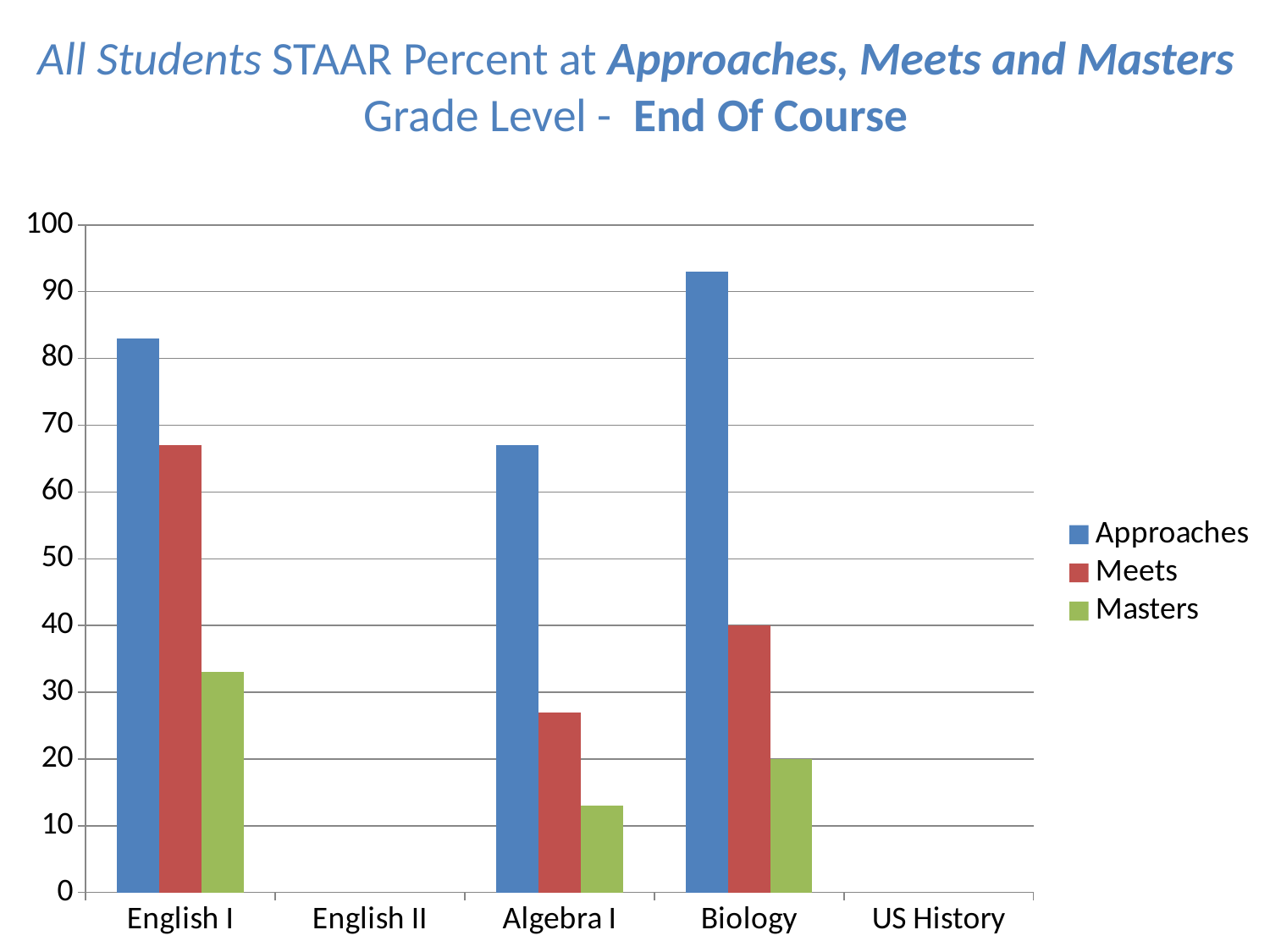
Which is larger, the Approaches value for Algebra I or the Approaches value for English I? English I How many series does the legend list? 3 What kind of chart is shown on the slide? bar chart Is the Masters value for English I greater or less than 30? greater Is the Approaches value for English I greater or less than 80? greater Which categories on the x axis have no bars plotted? English II and US History Which is larger, the Meets value for English I or the Meets value for Biology? English I How many categories are shown on the x axis? 5 Is the Approaches value for Biology greater or less than 90? greater Which category has the highest Approaches value? Biology Which category with plotted bars has the lowest Masters value? Algebra I